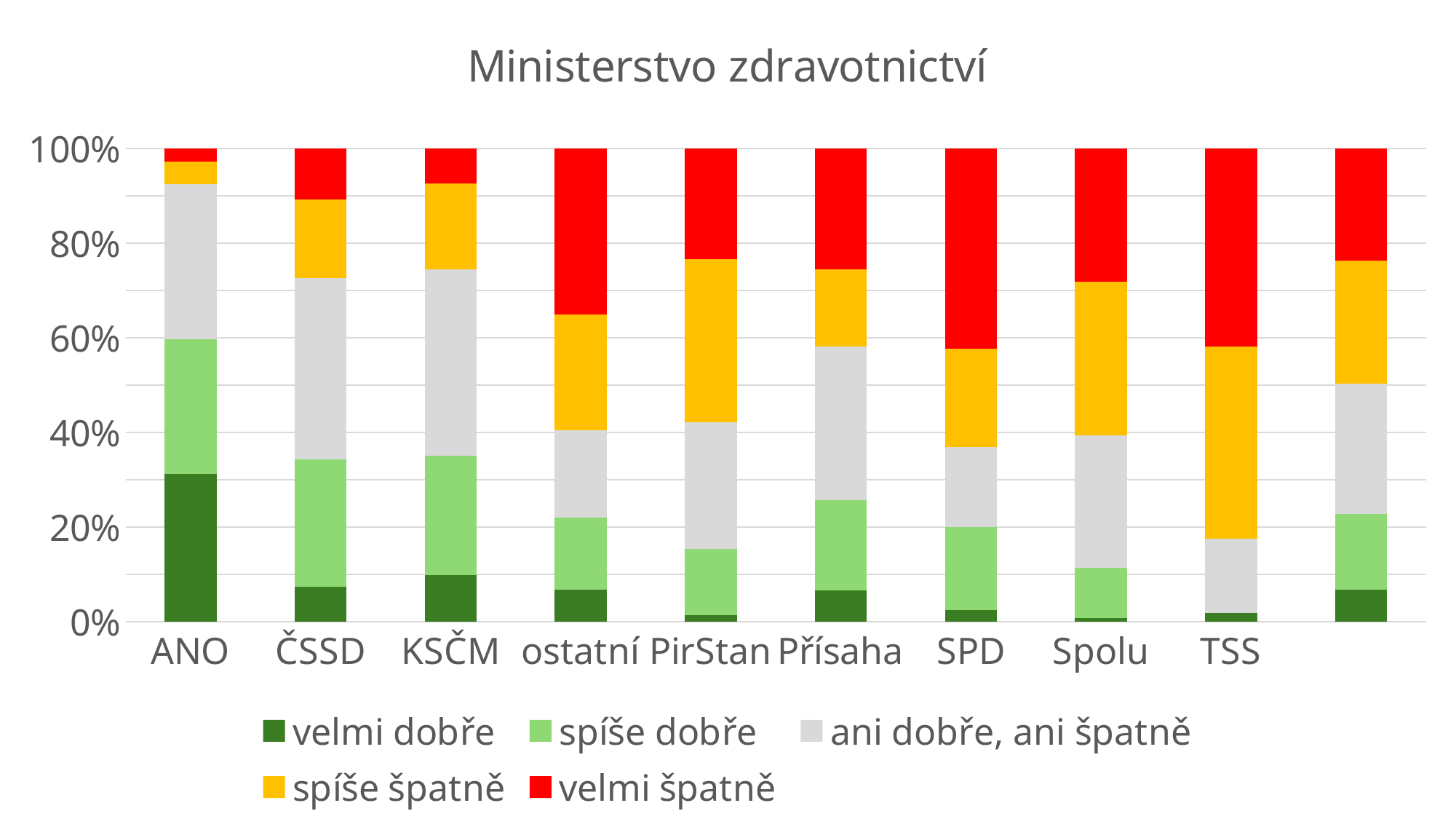
Is the 'velmi dobře' segment for Spolu greater or less than 20%? less Is the 'velmi dobře' segment for ANO greater or less than 40%? less Which colour represents the series 'velmi špatně' in the legend? red What is the title of the chart? Ministerstvo zdravotnictví Is the 'velmi špatně' segment for SPD greater or less than 20%? greater Which party has the largest 'velmi dobře' segment? ANO What kind of chart is shown on the slide? stacked bar chart How many bars are plotted in the chart? 10 Which party has the smallest 'velmi špatně' segment? ANO How many series does the legend list? 5 Which is larger, the 'velmi dobře' segment for ANO or for ČSSD? ANO